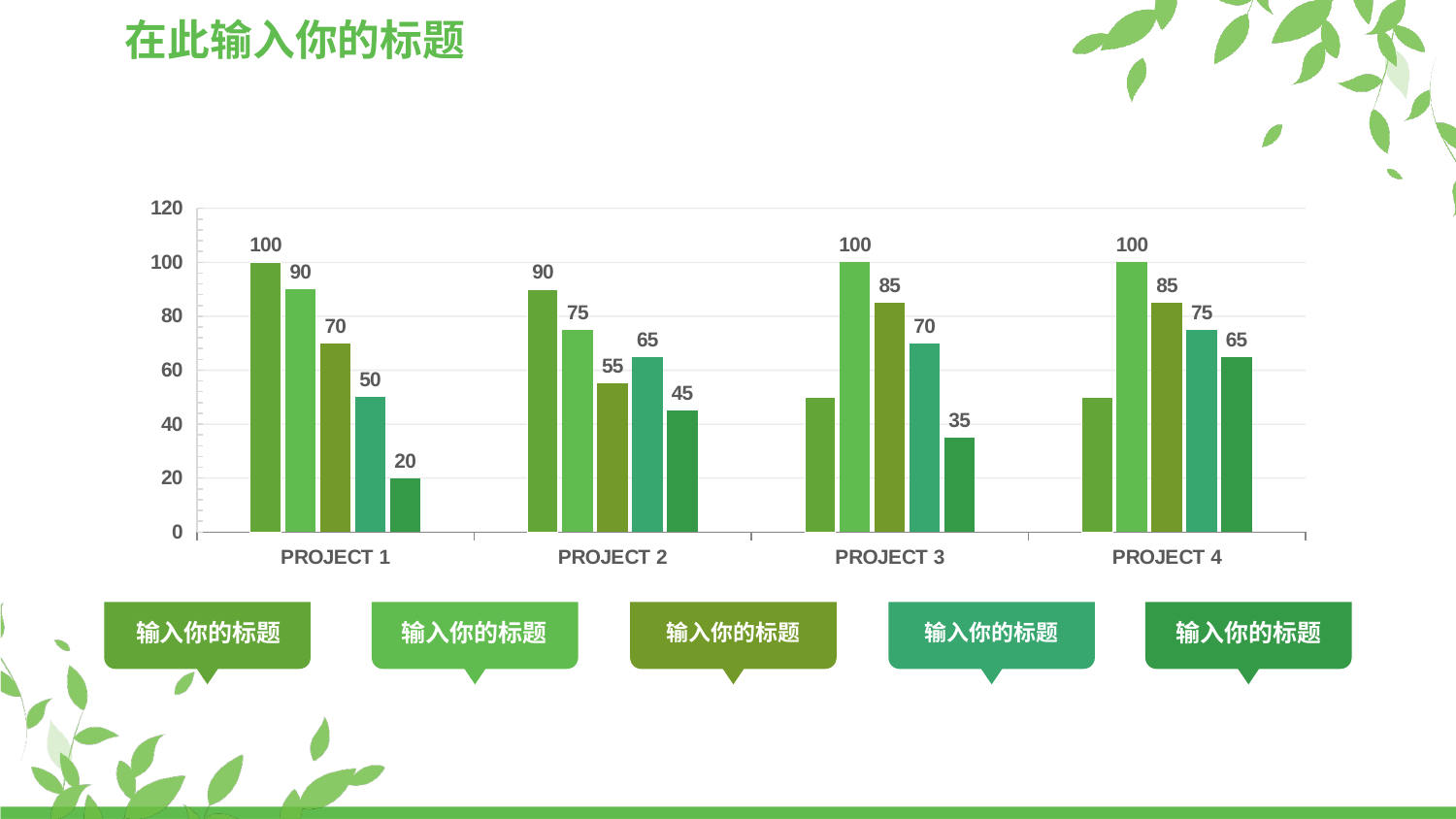
What is the value of the tallest bar in PROJECT 1? 100 What kind of chart is shown on the slide? bar chart What is the difference between the first and last bars in PROJECT 1? 80 Is the value of the unlabeled first bar in PROJECT 3 greater or less than 40? greater Within PROJECT 1, do the bar values rise or fall from left to right? fall What is the value of the second bar in PROJECT 2? 75 How many bars are in each project group? 5 What is the value of the shortest bar in PROJECT 1? 20 What is the value of the last (rightmost) bar in PROJECT 4? 65 In PROJECT 2, which is larger: the third bar (55) or the fourth bar (65)? the fourth bar (65) How many project categories are shown on the x axis? 4 What is the highest value shown on the vertical axis? 120